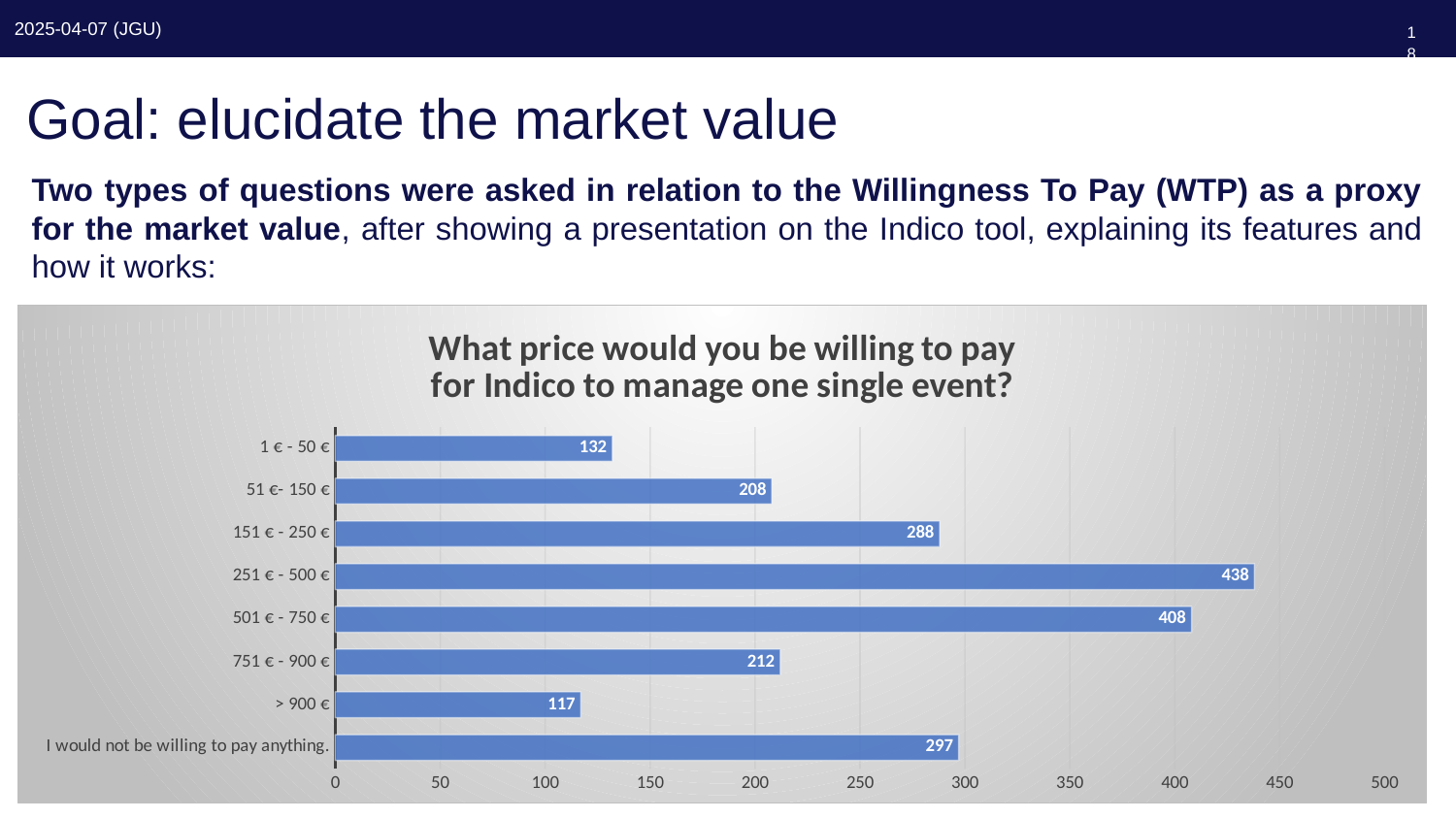
What is the title of the chart? What price would you be willing to pay for Indico to manage one single event? Which is larger, the value for "151 € - 250 €" or the value for "I would not be willing to pay anything."? I would not be willing to pay anything. Which category has the lowest value? > 900 € What is the value for the "251 € - 500 €" category? 438 How many categories are shown in the chart? 8 What is the value for "I would not be willing to pay anything."? 297 What is the difference between the values for "751 € - 900 €" and "1 € - 50 €"? 80 Which category has the highest value? 251 € - 500 € What is the value for the "> 900 €" category? 117 Is the value for "51 €- 150 €" greater or less than 200? greater What kind of chart is shown on the slide? Bar chart What is the difference between the values for "251 € - 500 €" and "501 € - 750 €"? 30